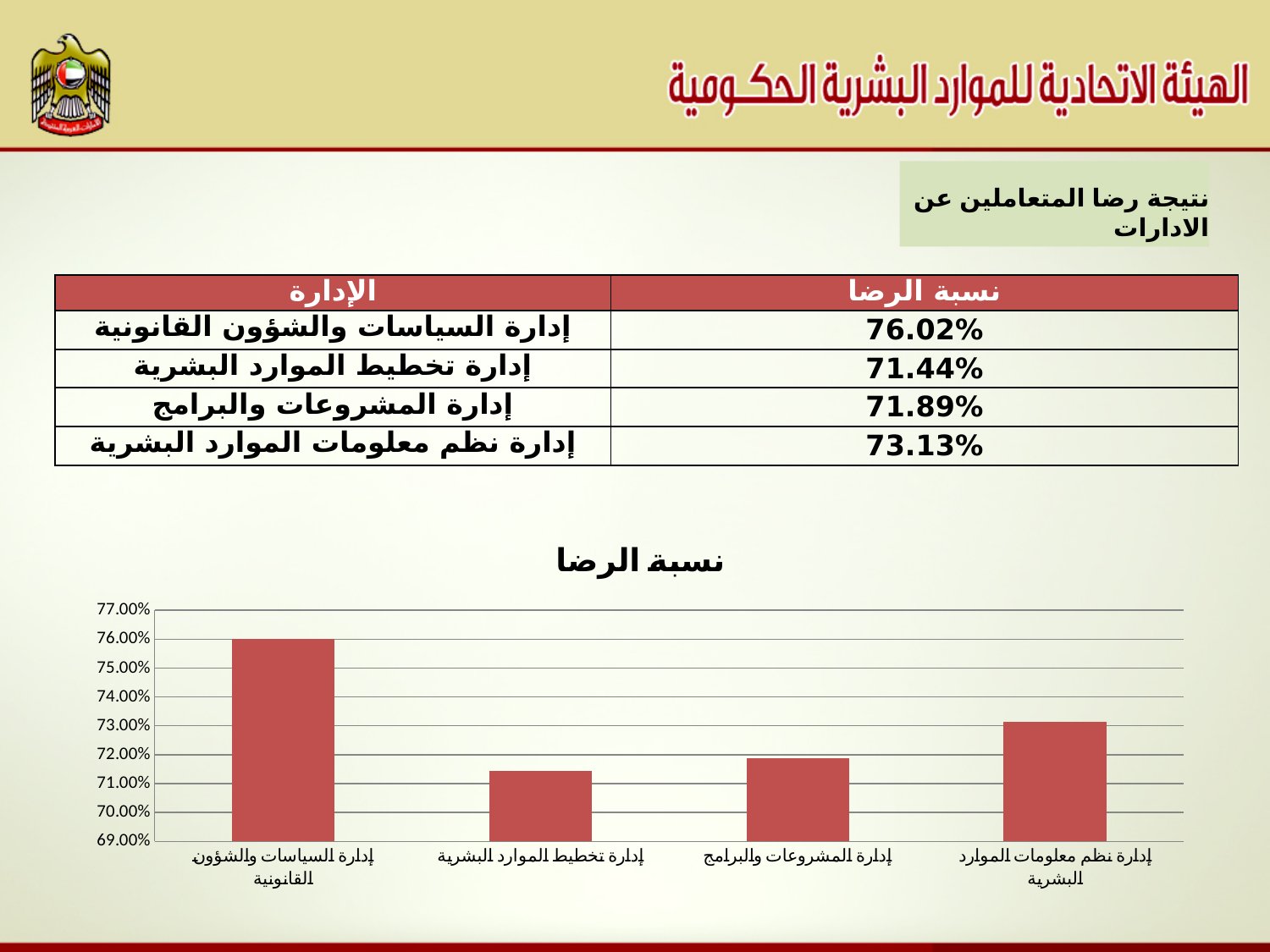
What kind of chart is shown on the slide? bar chart Is the value for إدارة تخطيط الموارد البشرية greater or less than 72.00%? less What is the satisfaction rate for إدارة السياسات والشؤون القانونية? 76.02% What is the satisfaction rate for إدارة المشروعات والبرامج? 71.89% What is the satisfaction rate for إدارة نظم معلومات الموارد البشرية? 73.13% Which has a higher satisfaction rate, إدارة نظم معلومات الموارد البشرية or إدارة المشروعات والبرامج? إدارة نظم معلومات الموارد البشرية Which department has the lowest satisfaction rate in the chart? إدارة تخطيط الموارد البشرية What is the title of the chart? نسبة الرضا What is the difference between the satisfaction rates of إدارة السياسات والشؤون القانونية and إدارة تخطيط الموارد البشرية? 4.58% Is the value for إدارة السياسات والشؤون القانونية greater or less than 75.00%? greater How many departments (bars) are shown in the chart? 4 Which department has the highest satisfaction rate in the chart? إدارة السياسات والشؤون القانونية